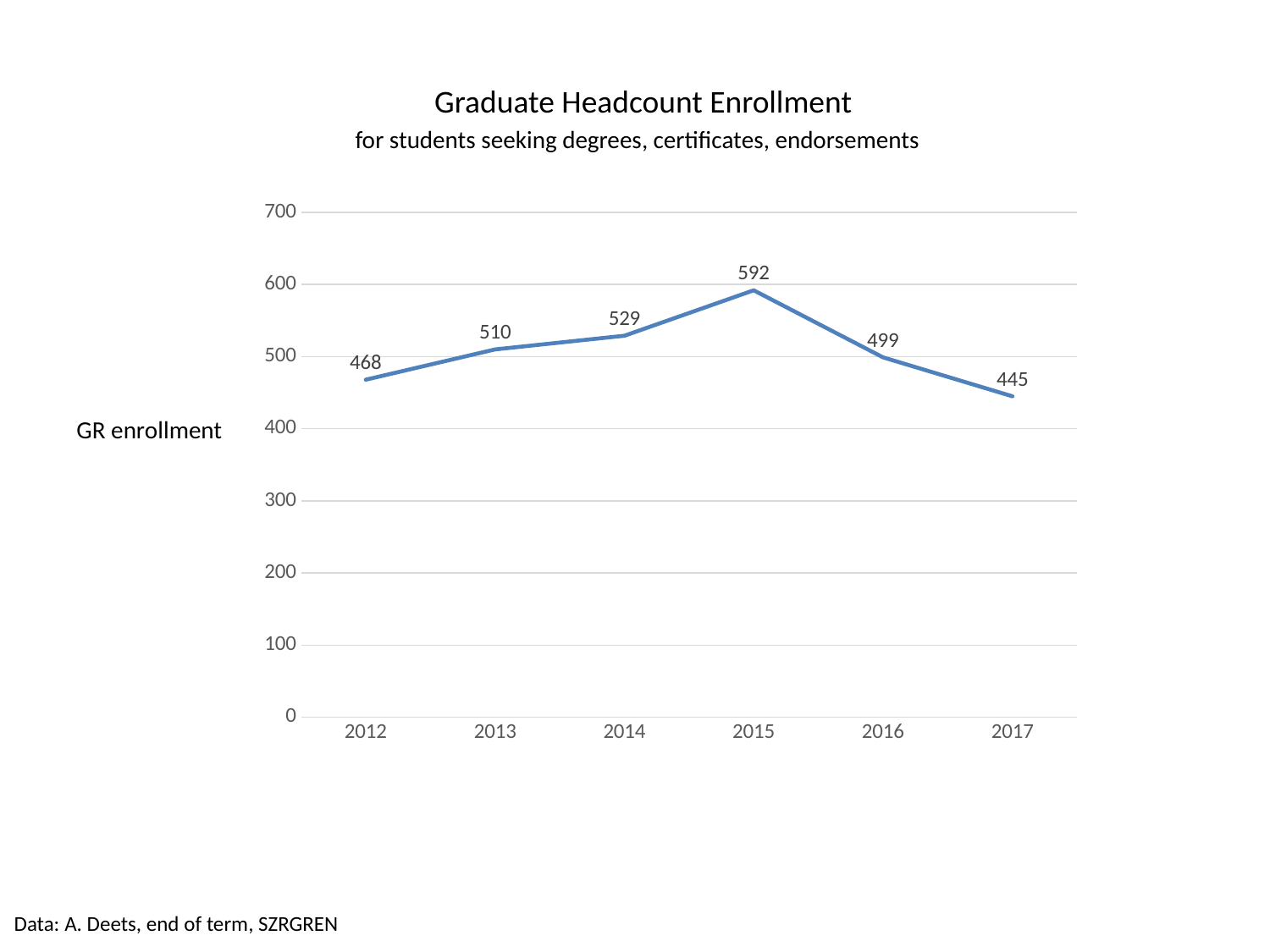
What kind of chart is shown on the slide? line chart What was the graduate headcount enrollment in 2012? 468 How many years are plotted on the chart? 6 What is the difference in graduate headcount enrollment between 2015 and 2016? 93 Which year had the lowest graduate headcount enrollment? 2017 Is the graduate headcount enrollment for 2014 greater or less than 500? greater Which year had a larger graduate headcount enrollment, 2012 or 2016? 2016 What was the graduate headcount enrollment in 2017? 445 Does graduate headcount enrollment rise or fall from 2015 to 2017? fall What is the difference in graduate headcount enrollment between 2014 and 2013? 19 Which year had the highest graduate headcount enrollment? 2015 What was the graduate headcount enrollment in 2015? 592